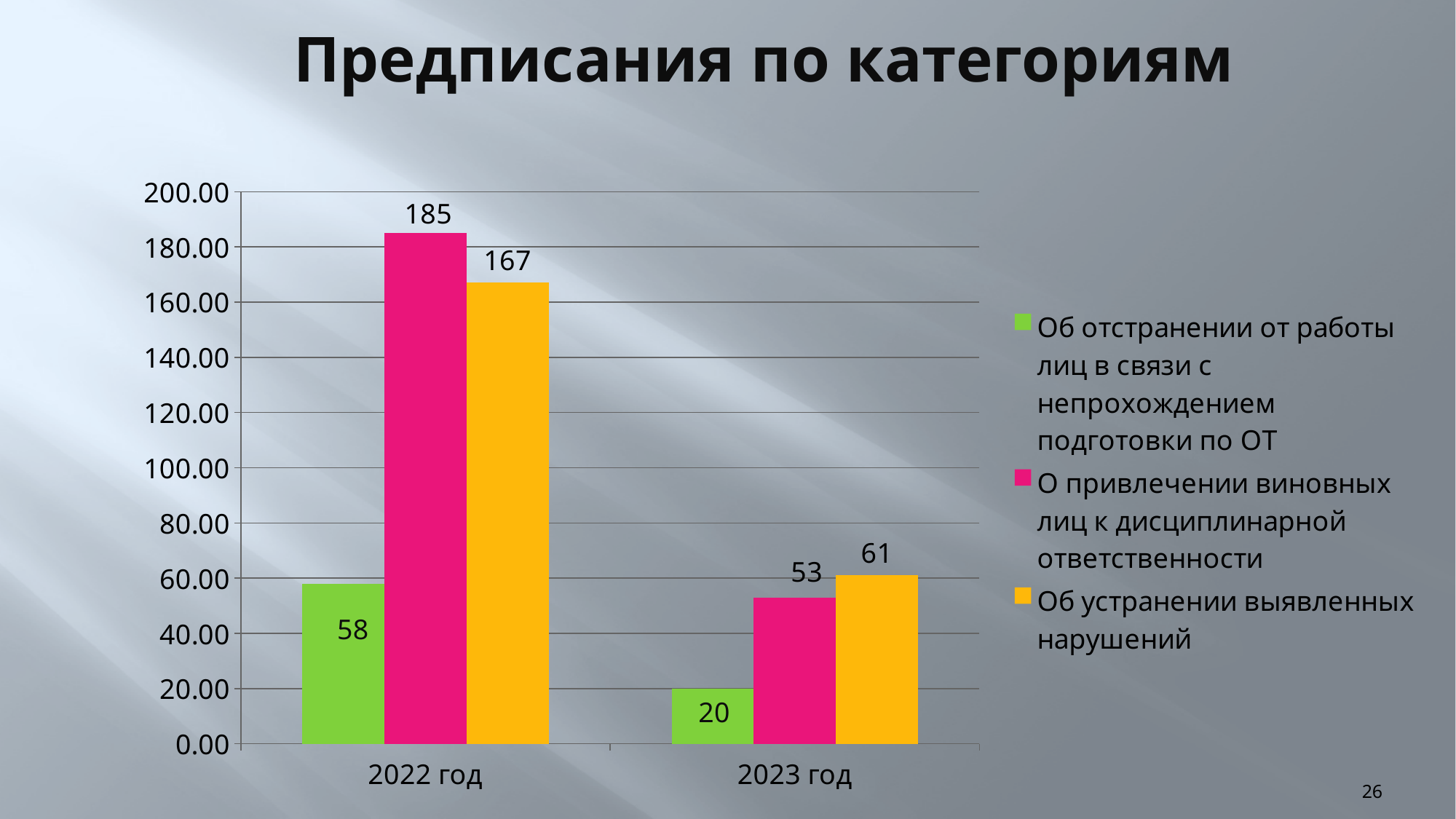
What is the difference between the 2022 год and 2023 год values for 'Об устранении выявленных нарушений'? 106 What kind of chart is shown on the slide? bar chart How many categories are shown on the x axis? 2 What is the value for 'Об устранении выявленных нарушений' in 2023 год? 61 What is the value for 'Об отстранении от работы лиц в связи с непрохождением подготовки по ОТ' in 2023 год? 20 What is the value for 'О привлечении виновных лиц к дисциплинарной ответственности' in 2022 год? 185 How many series does the legend list? 3 Is the value for 'Об отстранении от работы лиц в связи с непрохождением подготовки по ОТ' in 2022 год greater or less than 40.00? greater Which series has the highest value in 2022 год? О привлечении виновных лиц к дисциплинарной ответственности Which is larger in 2023 год: 'О привлечении виновных лиц к дисциплинарной ответственности' or 'Об устранении выявленных нарушений'? Об устранении выявленных нарушений Do the values for 'О привлечении виновных лиц к дисциплинарной ответственности' rise or fall from 2022 год to 2023 год? fall Which series has the lowest value in 2023 год? Об отстранении от работы лиц в связи с непрохождением подготовки по ОТ